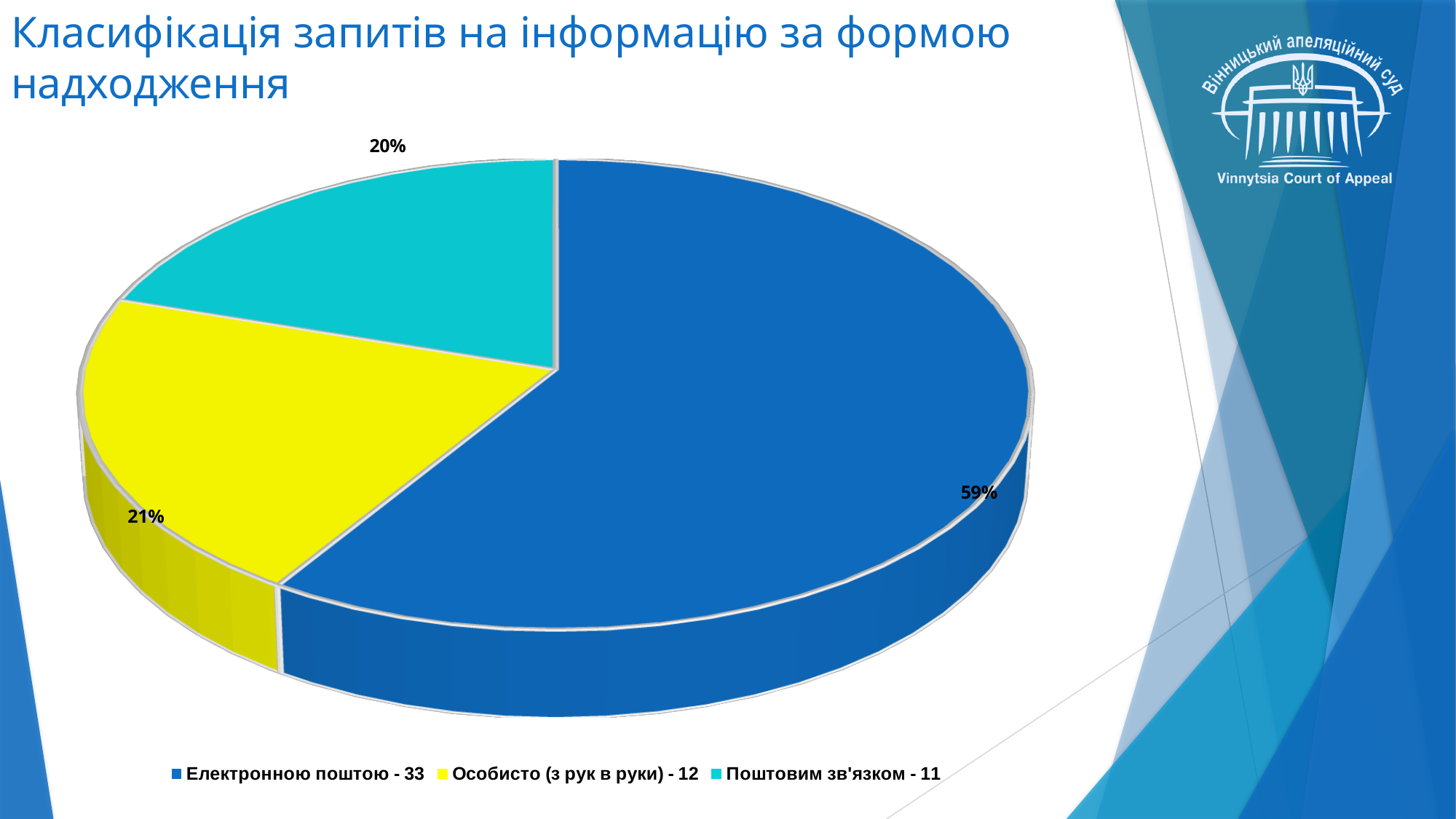
Which category has the largest share of the pie? Електронною поштою What type of chart is shown on the slide? Pie chart What percentage share does the slice for Електронною поштою have? 59% Which category has the smallest share of the pie? Поштовим зв'язком How many requests were received Особисто (з рук в руки) according to the legend? 12 What is the difference in percentage points between the Електронною поштою slice and the Особисто (з рук в руки) slice? 38 Which is larger: the number of requests received Особисто (з рук в руки) or by Поштовим зв'язком? Особисто (з рук в руки) How many categories does the pie chart show? 3 What percentage share does the slice for Поштовим зв'язком have? 20% What percentage share does the slice for Особисто (з рук в руки) have? 21% How many requests were received by Поштовим зв'язком according to the legend? 11 How many requests were received by Електронною поштою according to the legend? 33